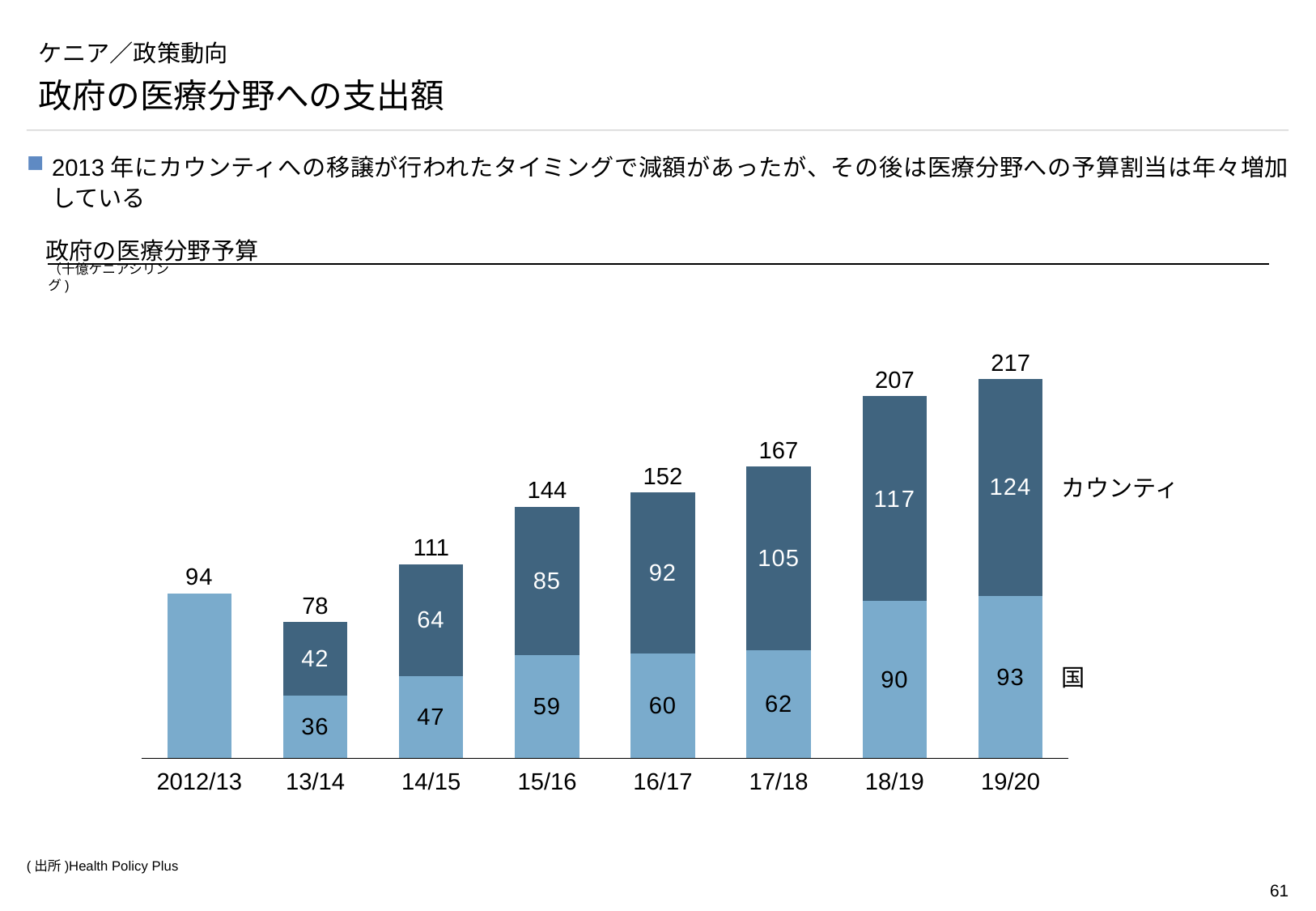
What is the title of the chart? 政府の医療分野予算 Which fiscal year has the highest total bar? 19/20 From 13/14 to 19/20, do the total values rise or fall? Rise What kind of chart is shown on the slide? Stacked bar chart How many fiscal years are shown on the x axis? 8 Which is larger for 14/15: the カウンティ segment or the 国 segment? カウンティ What is the total value of the bar for 19/20? 217 Which fiscal year has the lowest total bar? 13/14 What is the difference between the total for 18/19 and the total for 17/18? 40 What is the value of the 国 segment for 18/19? 90 How many series are shown in the stacked bars? 2 What is the value of the カウンティ segment for 15/16? 85